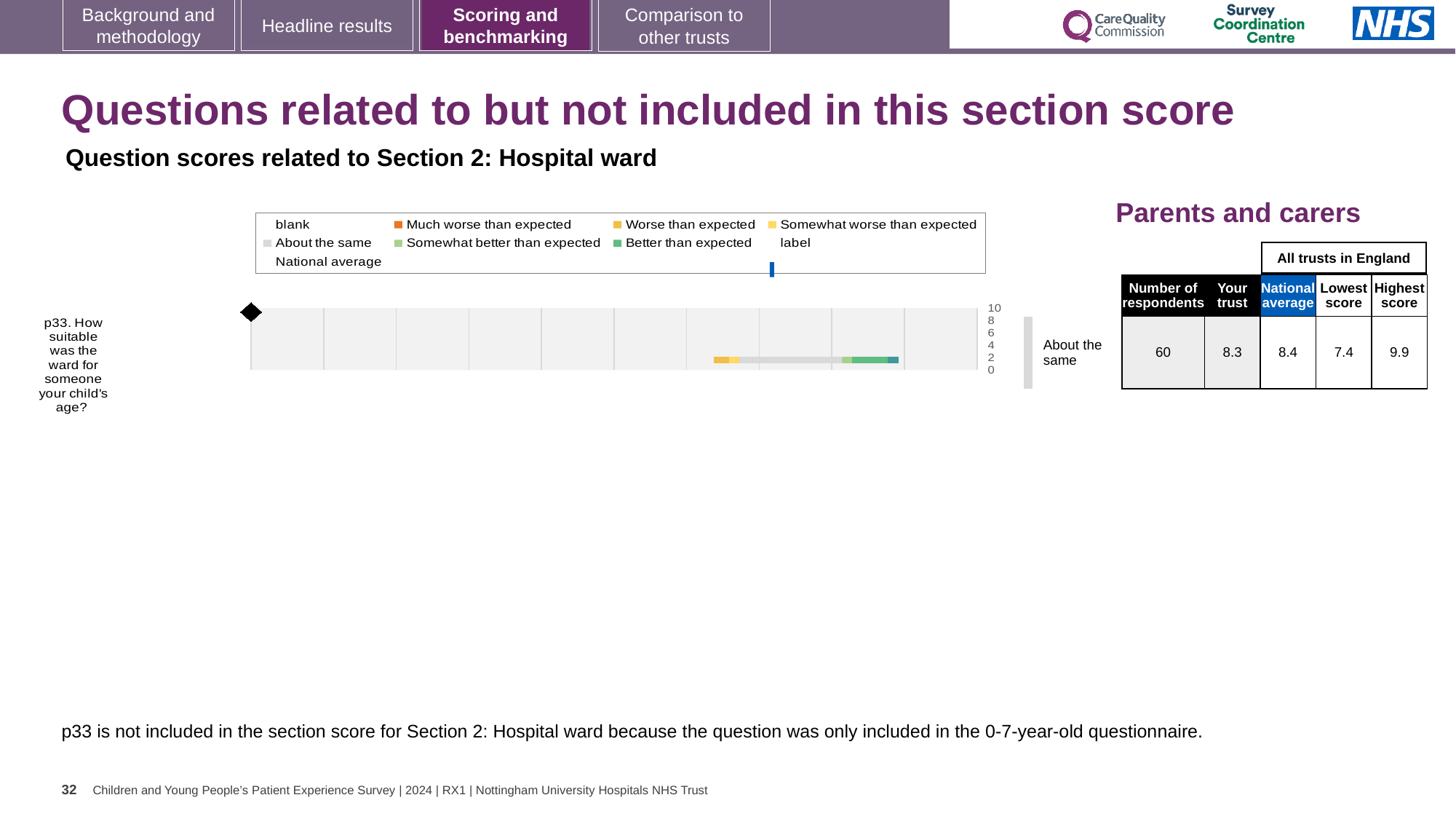
Which is larger for p33: the 'Your trust' score or the national average? National average What benchmark category label is shown to the right of the bar for p33? About the same What is the difference between the highest score and the lowest score for p33 in the table? 2.5 In the table, what is the lowest score among all trusts in England for p33? 7.4 In the table, what is the highest score among all trusts in England for p33? 9.9 In the table, how many respondents answered p33? 60 How many survey questions are plotted in the chart? 1 In the table, what is the national average score for p33? 8.4 Which survey question is plotted in the chart? p33. How suitable was the ward for someone your child's age? In the table, what is the 'Your trust' score for p33? 8.3 What is the maximum value shown on the chart's score axis? 10 What kind of chart is shown on the slide? bar chart